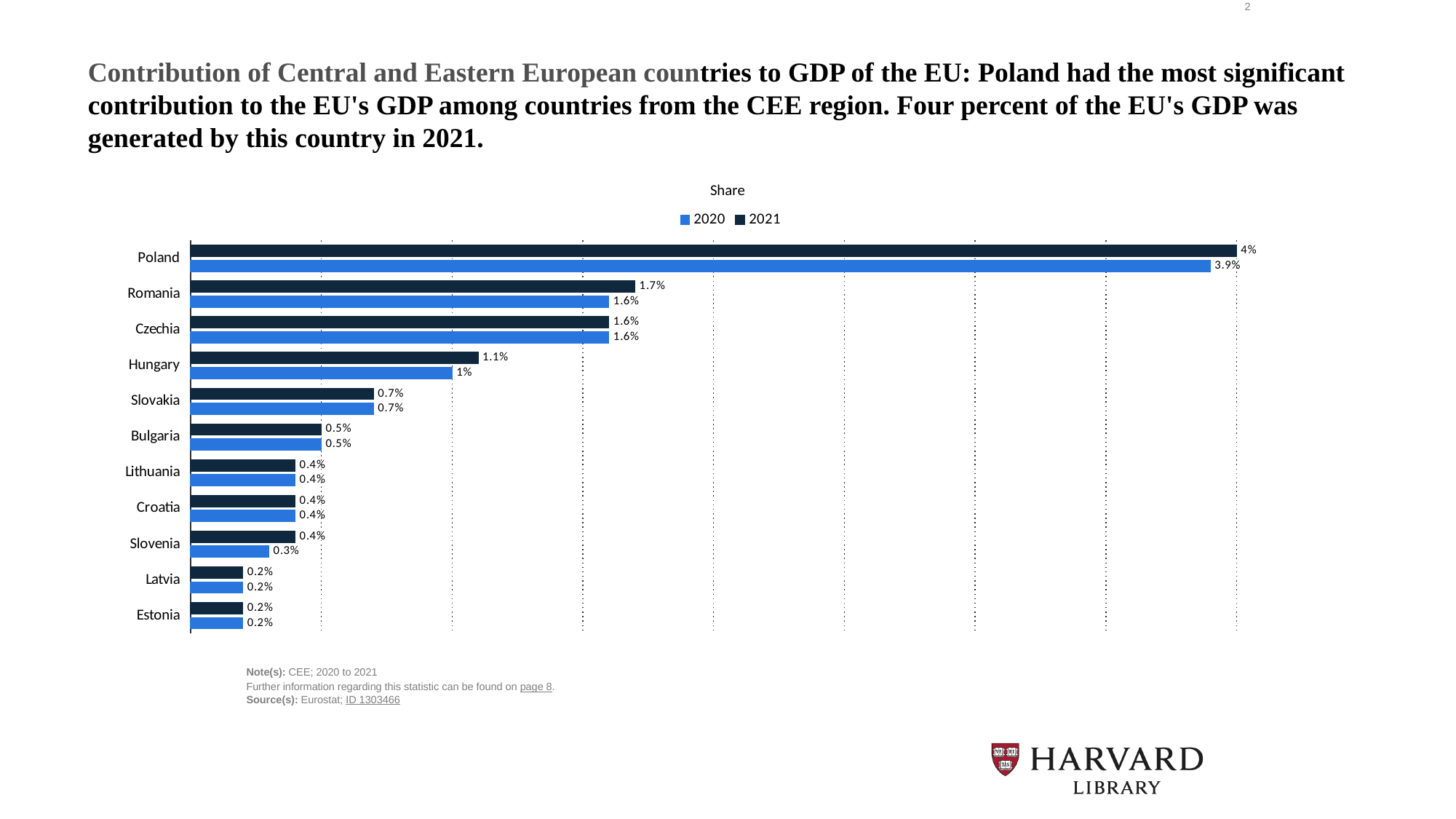
What is the difference between Poland's 2021 and 2020 values? 0.1% What is the value for Romania in 2020? 1.6% What is the value for Poland in 2021? 4% How many countries are shown on the chart? 11 What is the title of the chart? Share What is the difference between Romania's and Hungary's 2021 values? 0.6% What kind of chart is shown on the slide? Bar chart Which country has the highest value in 2021? Poland How many series does the legend list? 2 What is the value for Slovenia in 2020? 0.3% Which is larger, Romania's 2021 value or Czechia's 2021 value? Romania's 2021 value What is the value for Hungary in 2020? 1%